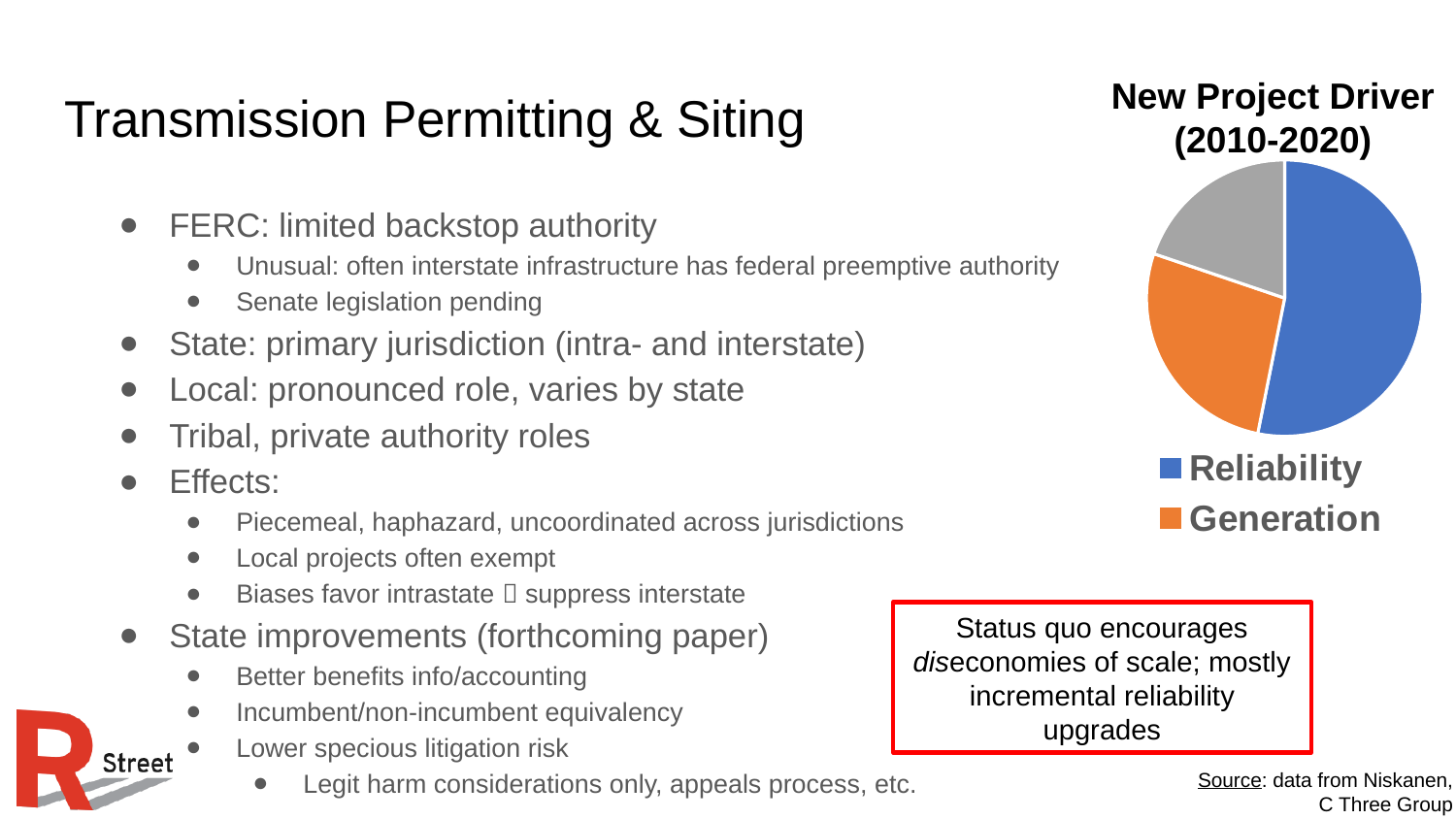
What kind of chart is shown on the slide? pie chart Which is larger in the pie chart, Reliability or Generation? Reliability Does the Reliability slice take up more or less than half of the pie chart? more What is the title of the pie chart? New Project Driver (2010-2020) How many slices does the pie chart have? 3 Which labelled category has the largest slice in the pie chart? Reliability How many entries does the legend of the pie chart list? 2 Which of the two labelled categories has the smaller slice in the pie chart? Generation Which legend entry is shown in blue in the pie chart? Reliability